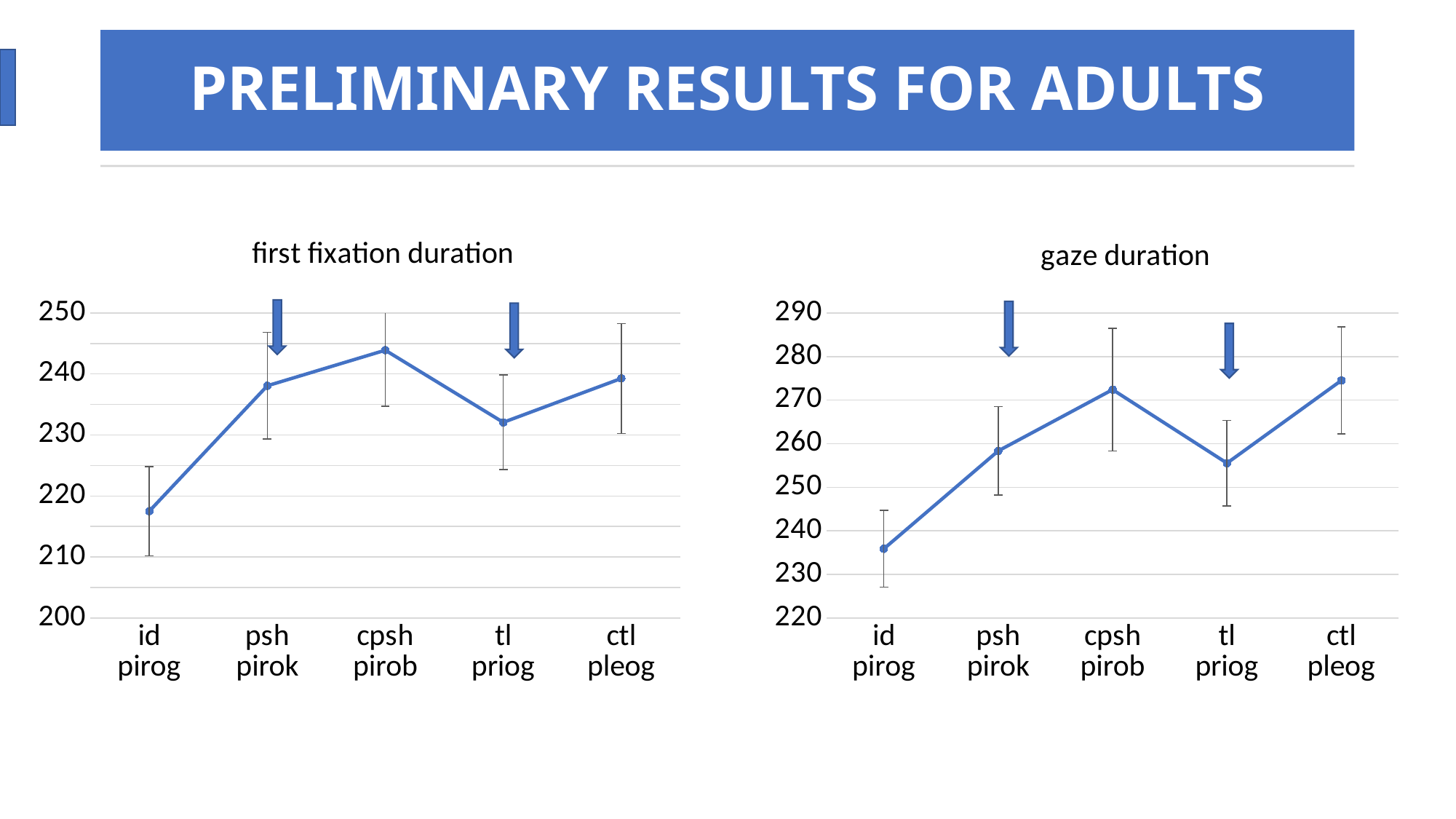
In the "first fixation duration" chart, which category has the highest value? cpsh pirob In the "gaze duration" chart, is the value for psh pirok greater or less than 260? less What is the title of the chart on the right side of the slide? gaze duration In the "gaze duration" chart, is the value for id pirog greater or less than 240? less In the "first fixation duration" chart, is the value for id pirog greater or less than 220? less What kind of chart is the "first fixation duration" chart? line chart In the "gaze duration" chart, which is larger, the value for cpsh pirob or the value for tl priog? cpsh pirob In the "first fixation duration" chart, which category has the lowest value? id pirog In the "first fixation duration" chart, does the value rise or fall from id pirog to psh pirok? rise In the "gaze duration" chart, which category has the lowest value? id pirog How many categories are plotted on the x axis of the "gaze duration" chart? 5